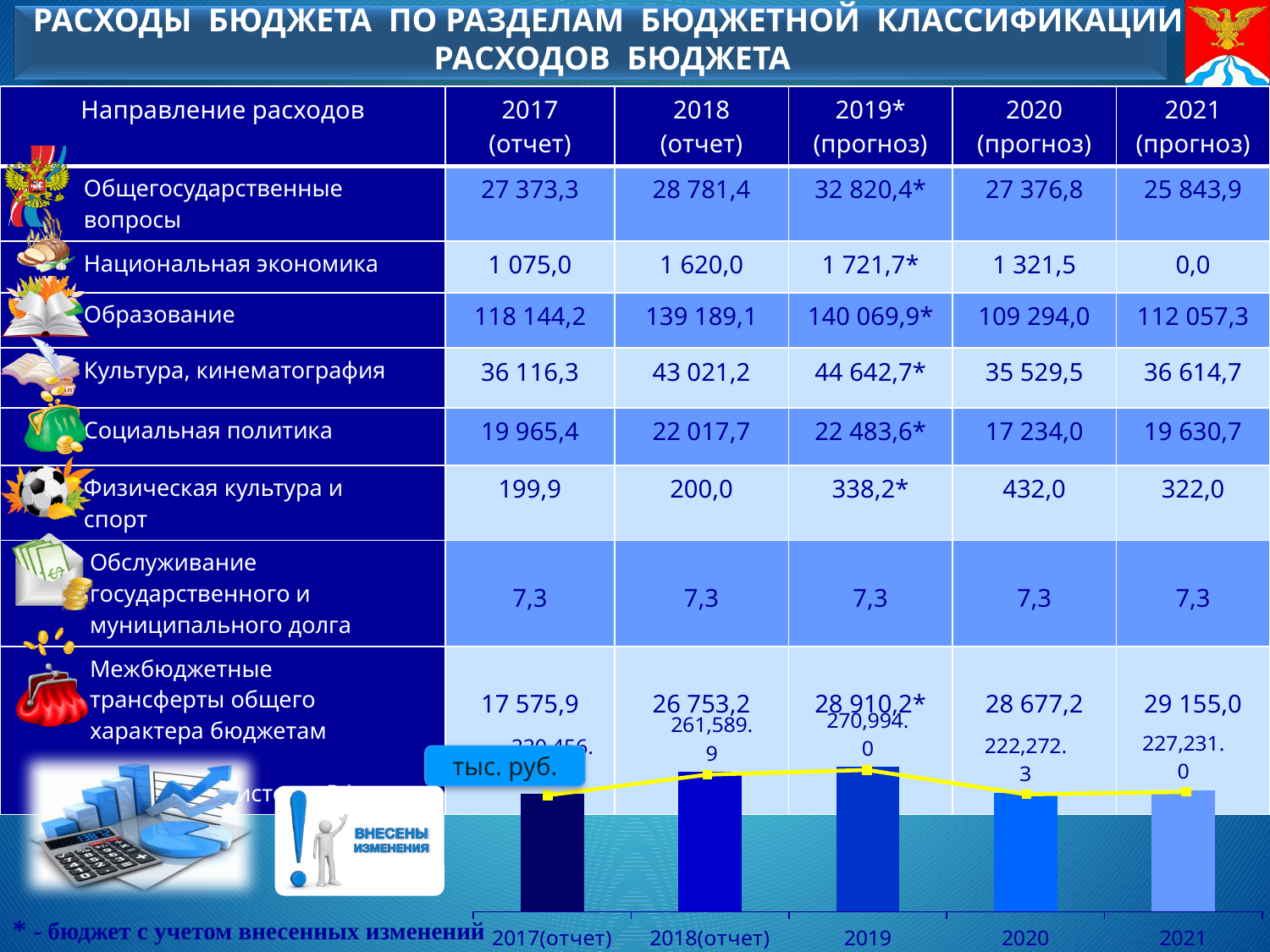
In the chart at the bottom of the slide, what is the value for 2020? 222,272.3 How many years are shown on the x axis of the chart at the bottom of the slide? 5 In the chart at the bottom of the slide, what is the difference between the values for 2019 and 2020? 48,721.7 In the chart at the bottom of the slide, what is the difference between the values for 2019 and 2018(отчет)? 9,404.1 In the chart at the bottom of the slide, what is the value for 2018(отчет)? 261,589.9 In the chart at the bottom of the slide, what is the value for 2021? 227,231.0 In the chart at the bottom of the slide, which year has the highest value? 2019 In the chart at the bottom of the slide, what is the difference between the values for 2021 and 2020? 4,958.7 In the chart at the bottom of the slide, what is the value for 2019? 270,994.0 In the chart at the bottom of the slide, does the value rise or fall from 2019 to 2020? fall In the chart at the bottom of the slide, which is larger: the value for 2018(отчет) or the value for 2020? 2018(отчет) What kind of chart is shown at the bottom of the slide? bar chart